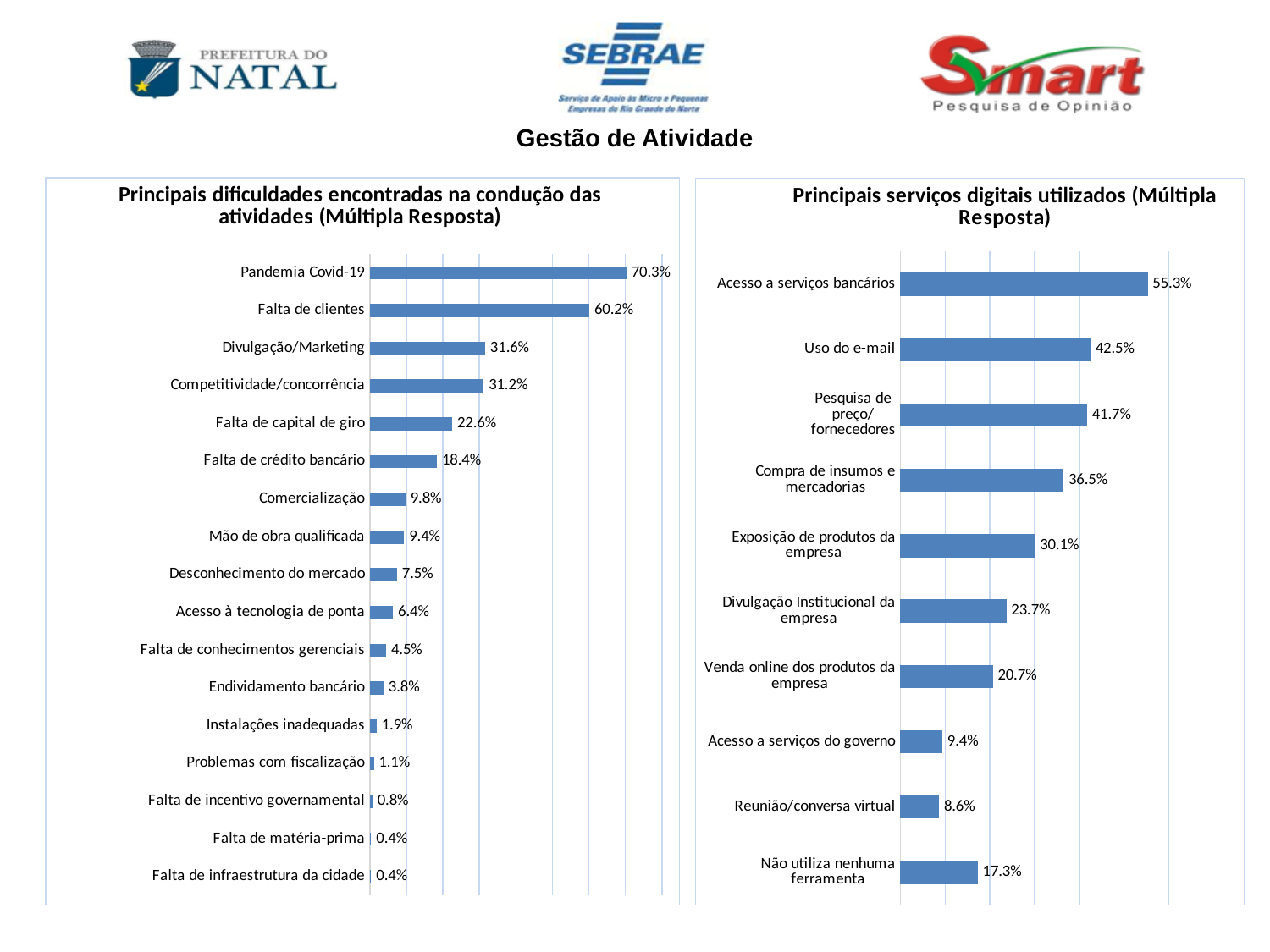
In the chart 'Principais dificuldades encontradas na condução das atividades', what is the difference between Pandemia Covid-19 and Falta de clientes? 10.1% In the chart 'Principais serviços digitais utilizados', what is the difference between Acesso a serviços bancários and Compra de insumos e mercadorias? 18.8% What type of chart is 'Principais serviços digitais utilizados'? Bar chart In the chart 'Principais dificuldades encontradas na condução das atividades', what is the value for Falta de capital de giro? 22.6% In the chart 'Principais dificuldades encontradas na condução das atividades', which is larger: Comercialização or Mão de obra qualificada? Comercialização In the chart 'Principais serviços digitais utilizados', what is the value for Uso do e-mail? 42.5% In the chart 'Principais serviços digitais utilizados', which category has the lowest value? Reunião/conversa virtual In the chart 'Principais dificuldades encontradas na condução das atividades', which category has the highest value? Pandemia Covid-19 In the chart 'Principais serviços digitais utilizados', how many categories are shown? 10 In the chart 'Principais serviços digitais utilizados', what is the value for Não utiliza nenhuma ferramenta? 17.3% In the chart 'Principais dificuldades encontradas na condução das atividades', how many categories are shown? 17 In the chart 'Principais dificuldades encontradas na condução das atividades', what is the value for Pandemia Covid-19? 70.3%